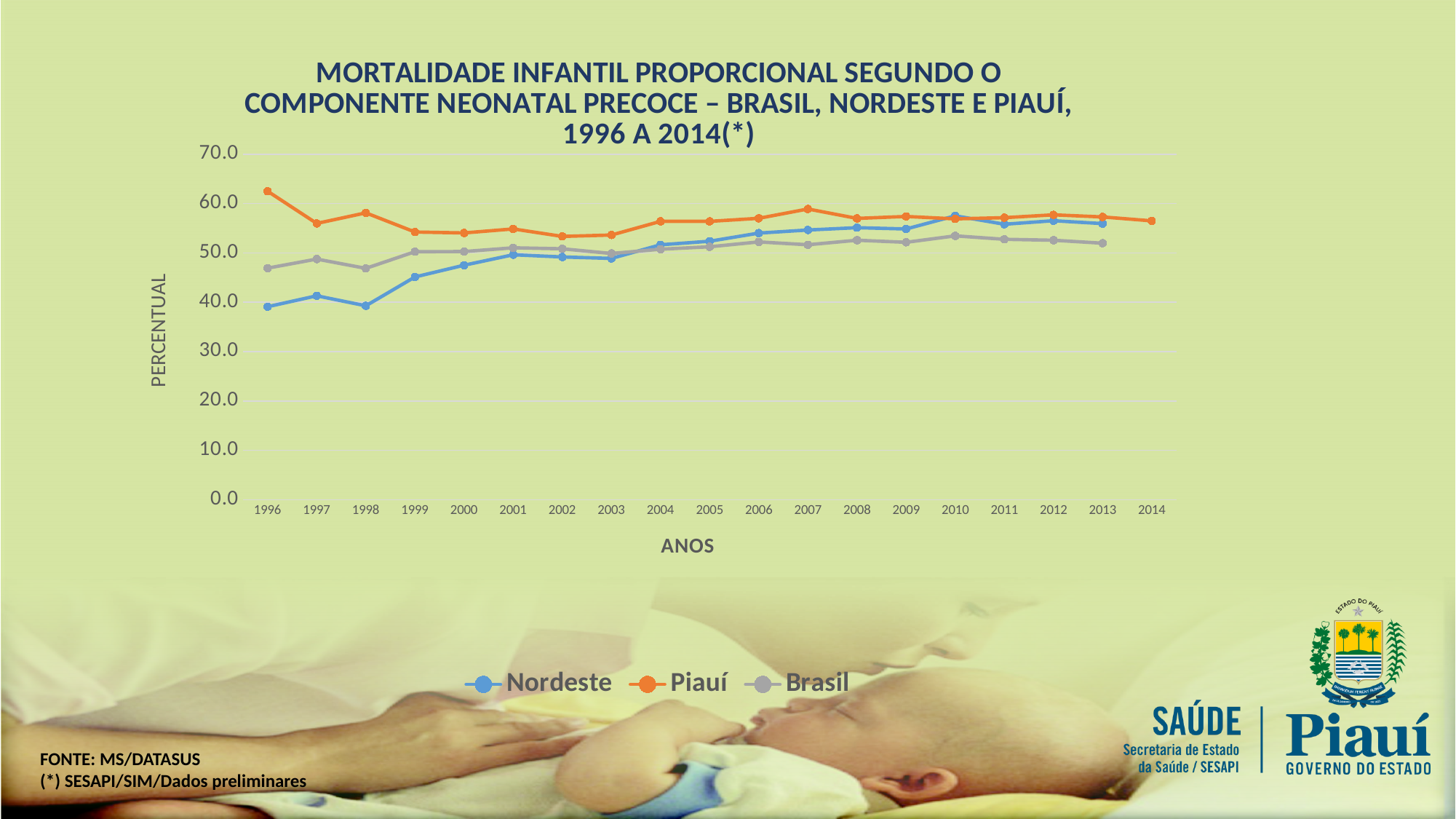
Which series has the highest value in 1996? Piauí Is the value for Brasil in 1996 greater or less than 50.0? less Is the value for Piauí in 1996 greater or less than 60.0? greater How many years are labelled on the x axis? 19 Which series has the lowest value in 1996? Nordeste Does the Nordeste series generally rise or fall from 1996 to 2013? rise In which year does the Piauí series reach its highest value? 1996 What is the title of the y axis? PERCENTUAL Which is larger in 1998, the value for Brasil or the value for Nordeste? Brasil What kind of chart is shown on the slide? line chart Is the value for Nordeste in 1999 greater or less than 50.0? less How many series does the legend list? 3